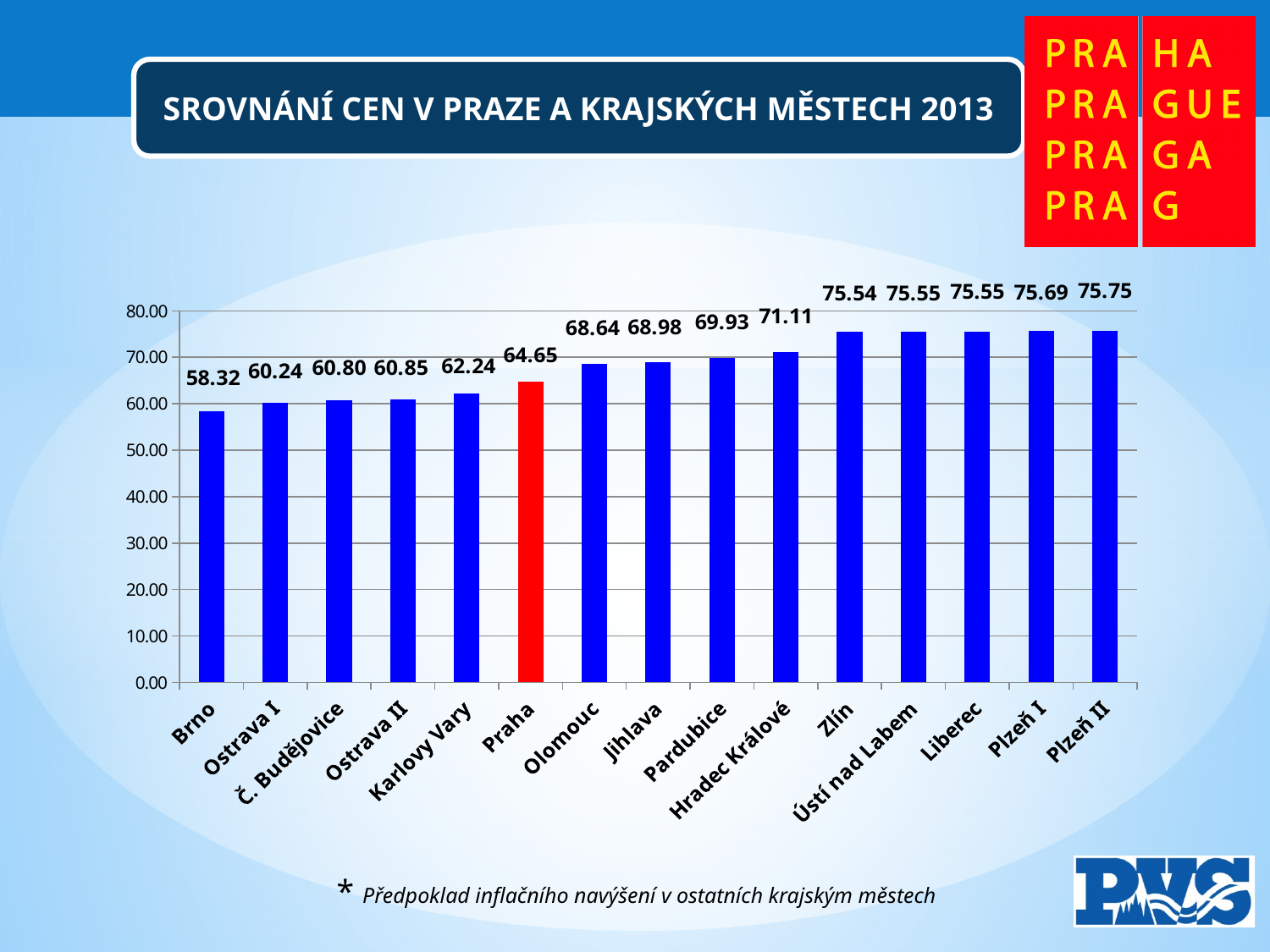
What kind of chart is shown on the slide? bar chart Do the values rise or fall from left to right along the x axis? rise Which city has the lowest value? Brno What is the value for Hradec Králové? 71.11 How many cities are shown on the x axis? 15 What is the value for Praha? 64.65 Which is larger, the value for Olomouc or the value for Karlovy Vary? Olomouc Which city's bar is coloured red? Praha What is the difference between the values for Praha and Brno? 6.33 Is the value for Karlovy Vary greater or less than 70.00? less What is the value for Ostrava I? 60.24 Which city has the highest value? Plzeň II